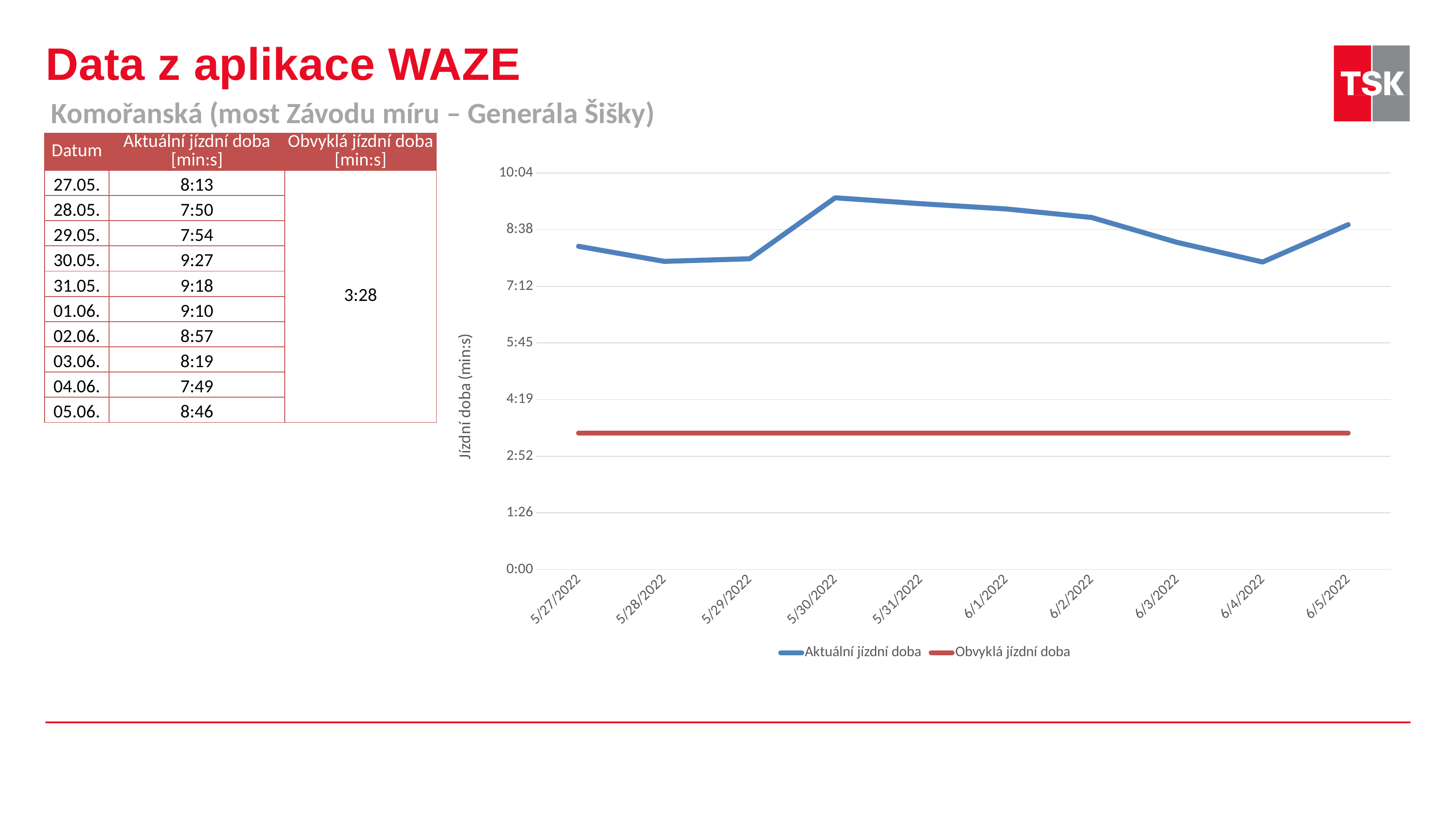
What is the value of the Obvyklá jízdní doba series? 3:28 Which is larger, the Aktuální jízdní doba on 5/31/2022 or on 6/3/2022? 5/31/2022 Is the Aktuální jízdní doba value for 5/30/2022 greater or less than 8:38? greater How many dates are plotted along the x axis of the chart? 10 What is the difference between the Aktuální jízdní doba on 5/30/2022 and the Obvyklá jízdní doba? 5:59 What colour is the Obvyklá jízdní doba line in the chart? red What is the Aktuální jízdní doba value for 6/4/2022? 7:49 How many series does the chart legend list? 2 On which date is the Aktuální jízdní doba highest? 5/30/2022 What kind of chart is shown on the slide? line chart Does the Aktuální jízdní doba rise or fall from 5/30/2022 to 6/4/2022? fall What is the Aktuální jízdní doba value for 5/30/2022? 9:27